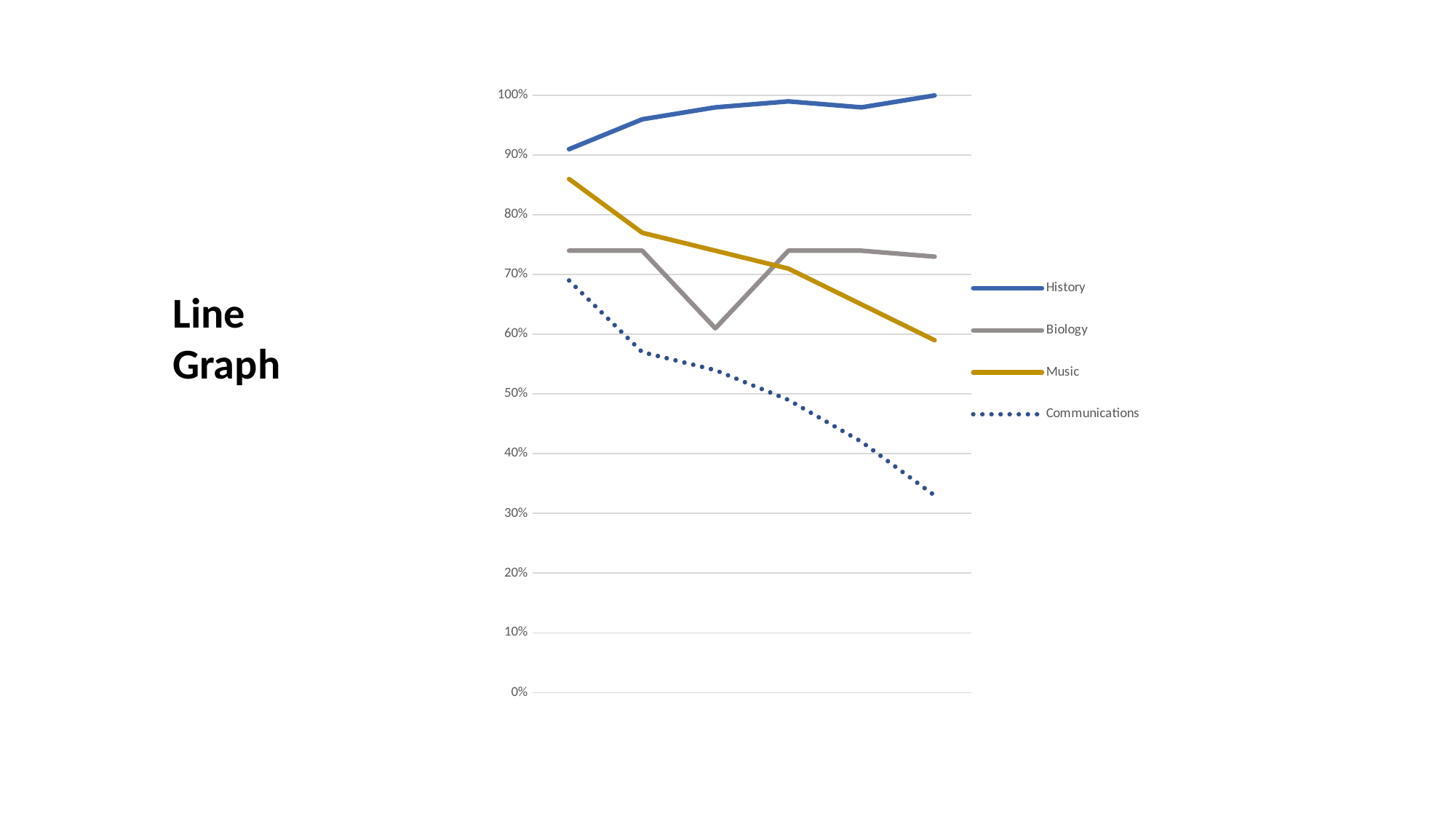
Which series is drawn with a dotted line? Communications How many data points does each line have? 6 What kind of chart is shown on the slide? line chart At the last point, which is larger: Biology or Music? Biology Which series has the highest values throughout the chart? History What is the value of the last point of the History line? 100% Do the values for Communications rise or fall along the x axis? fall Is the last value for Communications greater or less than 40%? less Do the values for History generally rise or fall along the x axis? rise Is the first value for Music greater or less than 80%? greater How many series does the legend list? 4 Which series has the lowest values throughout the chart? Communications